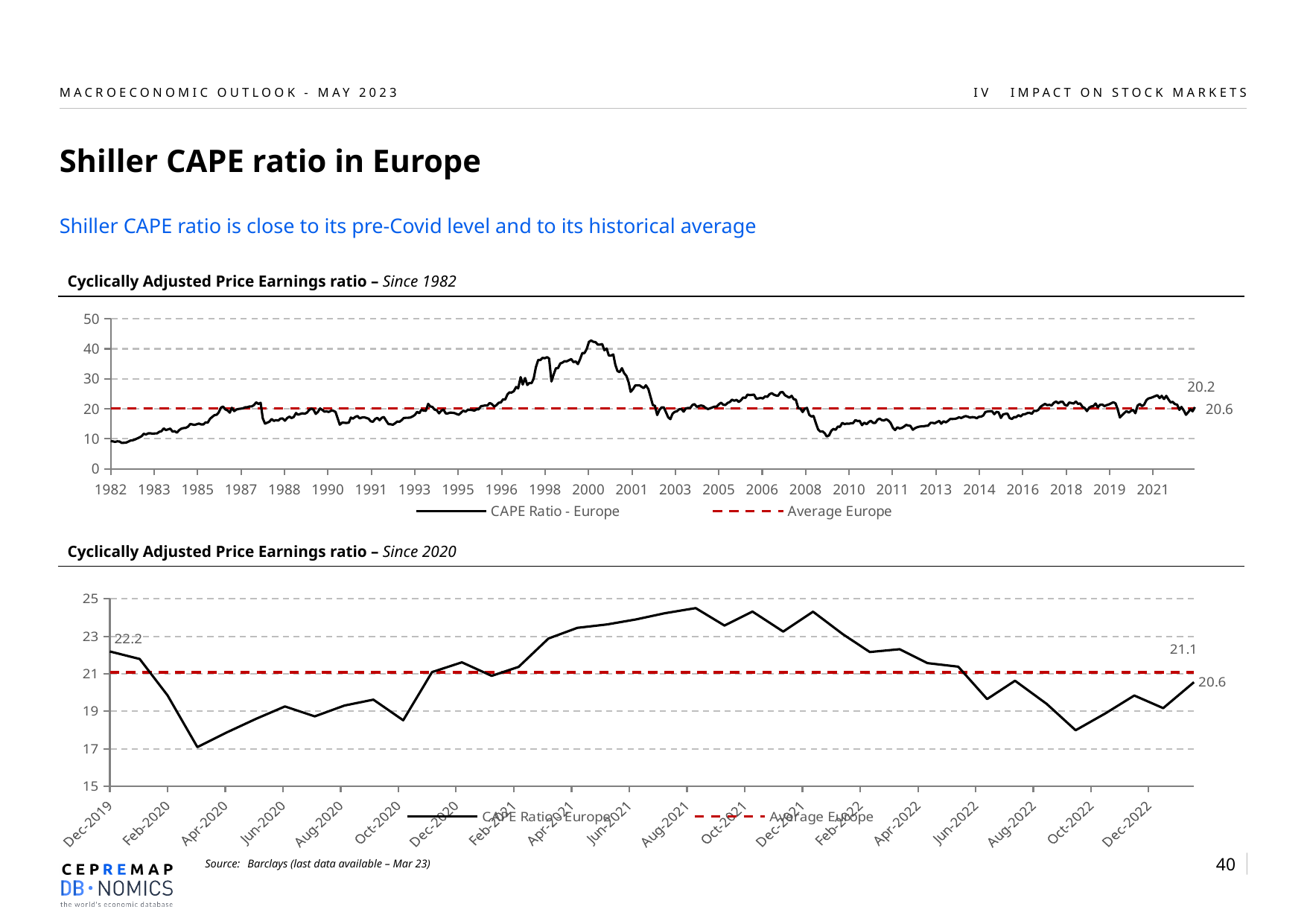
In the 'Since 2020' chart, what is the last labelled value of the CAPE Ratio - Europe line? 20.6 In the 'Since 1982' chart, is the peak of the CAPE Ratio - Europe line around 2000 greater or less than 40? greater In the 'Since 2020' chart, what is the difference between the Dec-2019 value (22.2) and the last labelled value (20.6) of the CAPE Ratio - Europe line? 1.6 In the 'Since 2020' chart, what is the CAPE Ratio - Europe value labelled at Dec-2019? 22.2 In the 'Since 2020' chart, what value is labelled for the Average Europe line? 21.1 In the 'Since 2020' chart, is the CAPE Ratio - Europe value at Apr-2020 greater or less than 19? less In the 'Since 2020' chart, which is larger: the CAPE Ratio - Europe value at Dec-2019 or at Dec-2022? Dec-2019 How many series does the legend of the 'Since 2020' chart list? 2 In the 'Since 2020' chart, at which date does the CAPE Ratio - Europe line reach its lowest point? Mar-2020 What kind of chart is the 'Cyclically Adjusted Price Earnings ratio – Since 1982' chart? line chart In the 'Since 1982' chart, what value is labelled for the Average Europe line? 20.2 What are the two legend entries of the 'Since 1982' chart? CAPE Ratio - Europe; Average Europe